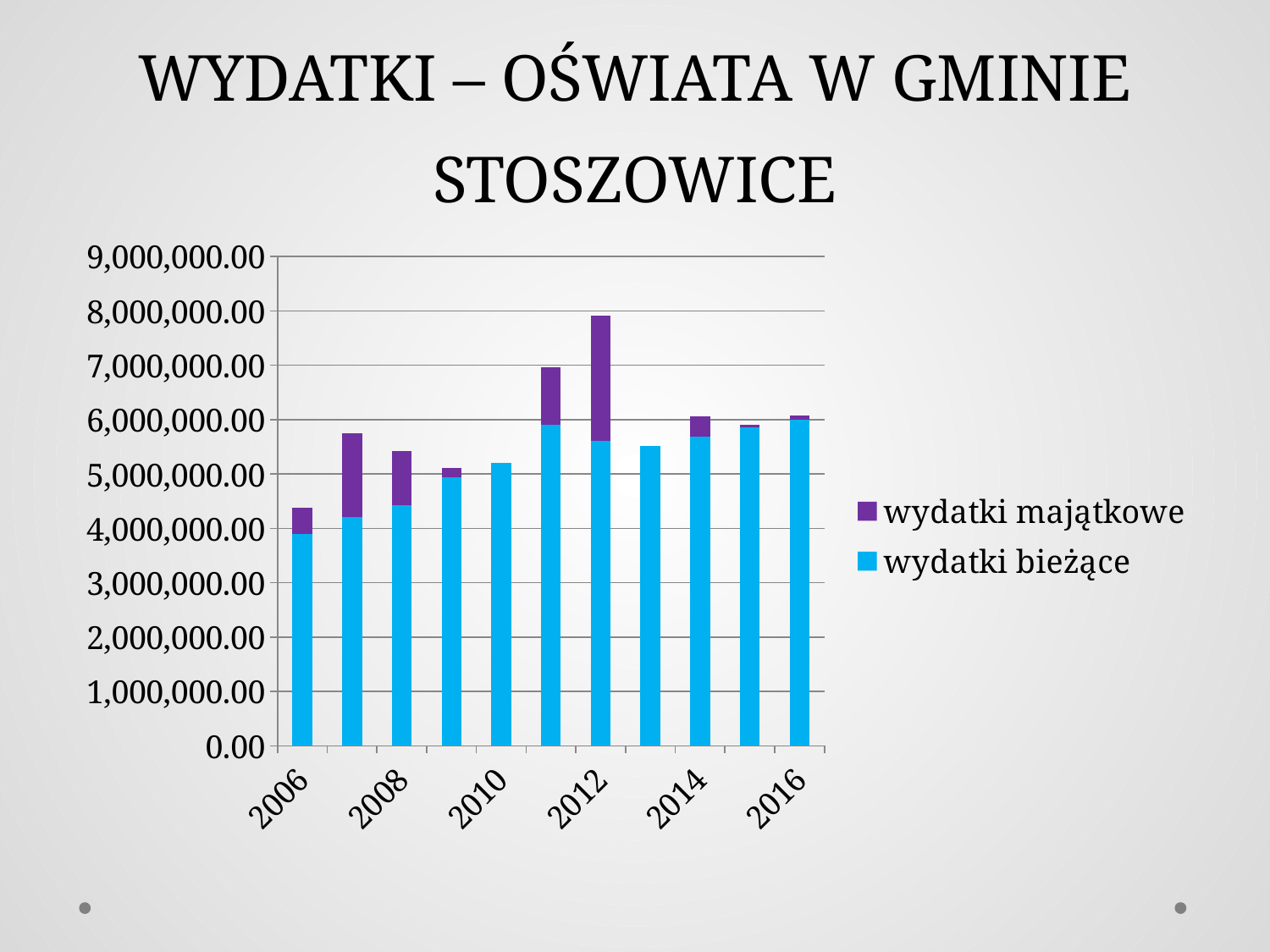
How many series does the legend list? 2 Which year has the lowest total expenditure (shortest stacked bar)? 2006 Is the total value for 2012 greater or less than 7,000,000.00? greater Do the wydatki bieżące values generally rise or fall from 2006 to 2016? rise Which series is shown in purple in the legend? wydatki majątkowe Which year has the larger total expenditure, 2011 or 2012? 2012 Which year has the larger wydatki majątkowe (purple) segment, 2011 or 2012? 2012 Is the total value for 2013 greater or less than 6,000,000.00? less What kind of chart is shown on the slide? stacked bar chart How many years (bars) are plotted in the chart? 11 Which year has the highest total expenditure (tallest stacked bar)? 2012 Is the total value for 2006 greater or less than 5,000,000.00? less